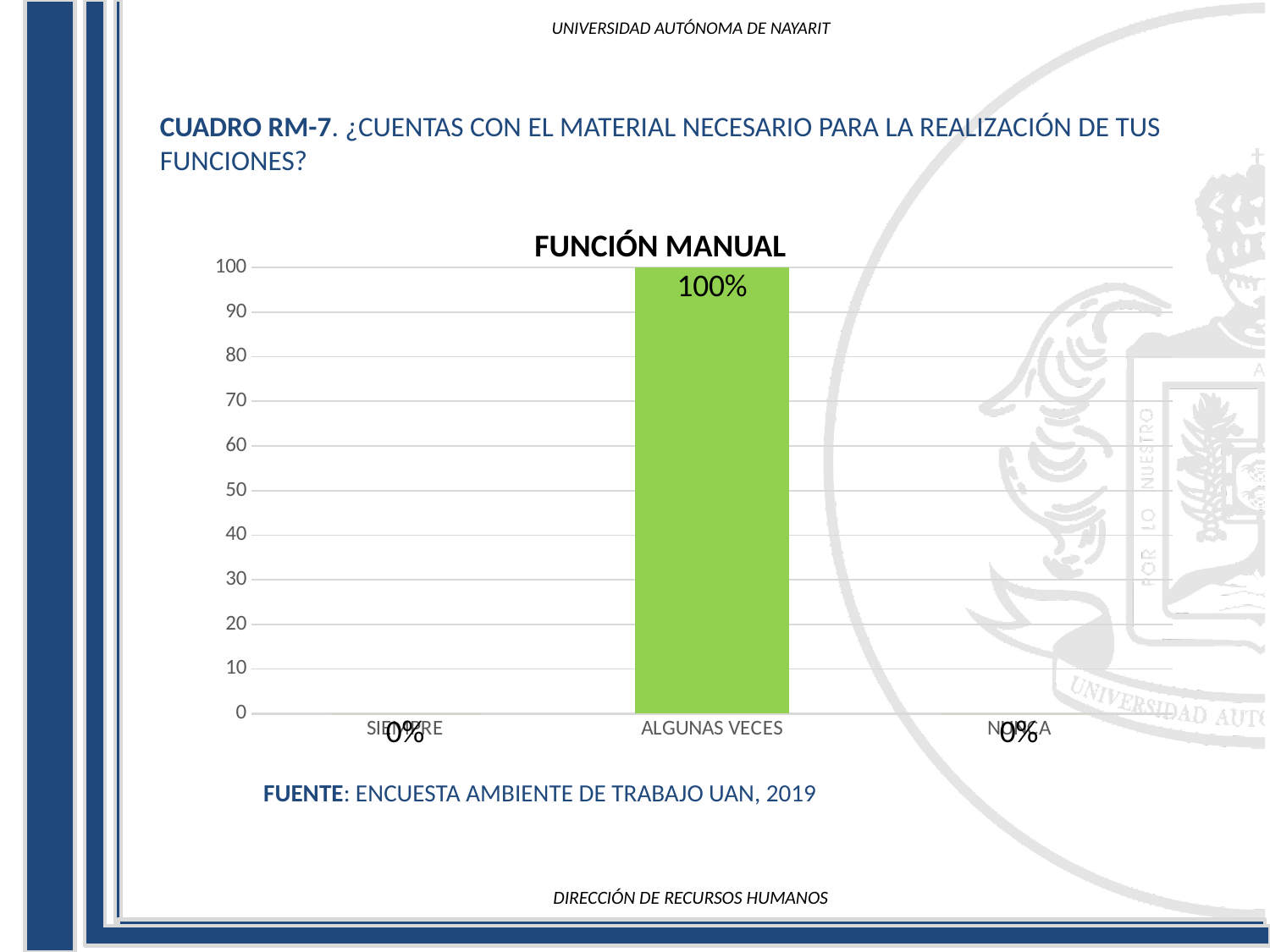
What is the value for SIEMPRE? 0% What is the title of the chart? FUNCIÓN MANUAL What kind of chart is shown? bar chart Which is larger, the value for ALGUNAS VECES or the value for NUNCA? ALGUNAS VECES What colour is the bar for ALGUNAS VECES? green How many categories are shown on the x axis? 3 What is the highest value shown on the y axis? 100 What is the value for NUNCA? 0% Is the value for ALGUNAS VECES greater or less than 50? greater What is the difference between the values for ALGUNAS VECES and SIEMPRE? 100% What is the value for ALGUNAS VECES? 100% Which category has the highest value? ALGUNAS VECES